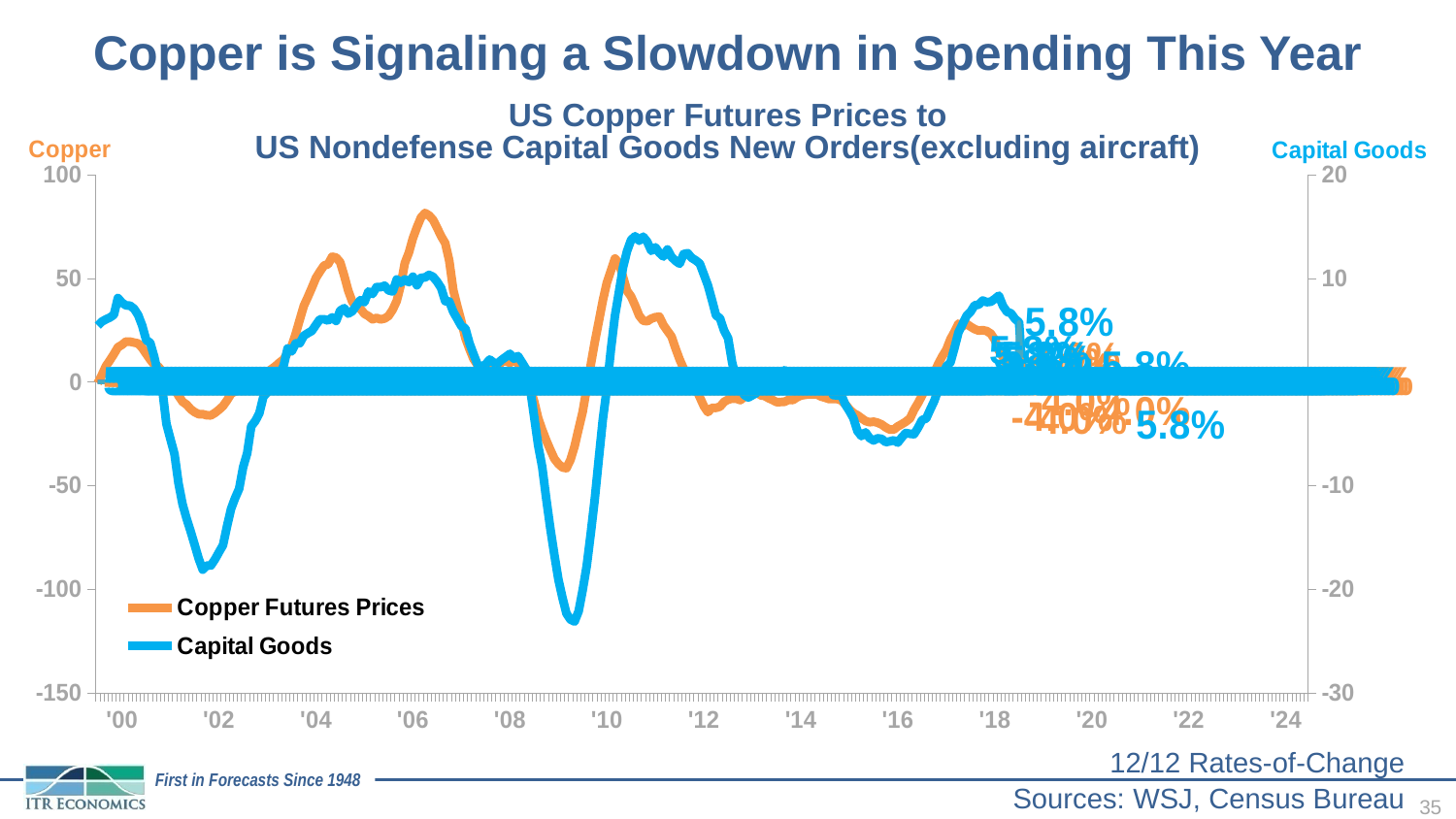
Is the value of Copper Futures Prices around '09 greater or less than 0 on the Copper axis? less Is the lowest value of Capital Goods around '09 greater or less than -20 on the Capital Goods axis? less Is the lowest value of Capital Goods around '02 greater or less than -10 on the Capital Goods axis? less How many series does the legend list? 2 What is the title of the chart? US Copper Futures Prices to US Nondefense Capital Goods New Orders(excluding aircraft) What is the minimum value shown on the right (Capital Goods) axis? -30 Which series is drawn in blue? Capital Goods What kind of chart is shown on the slide? Line chart